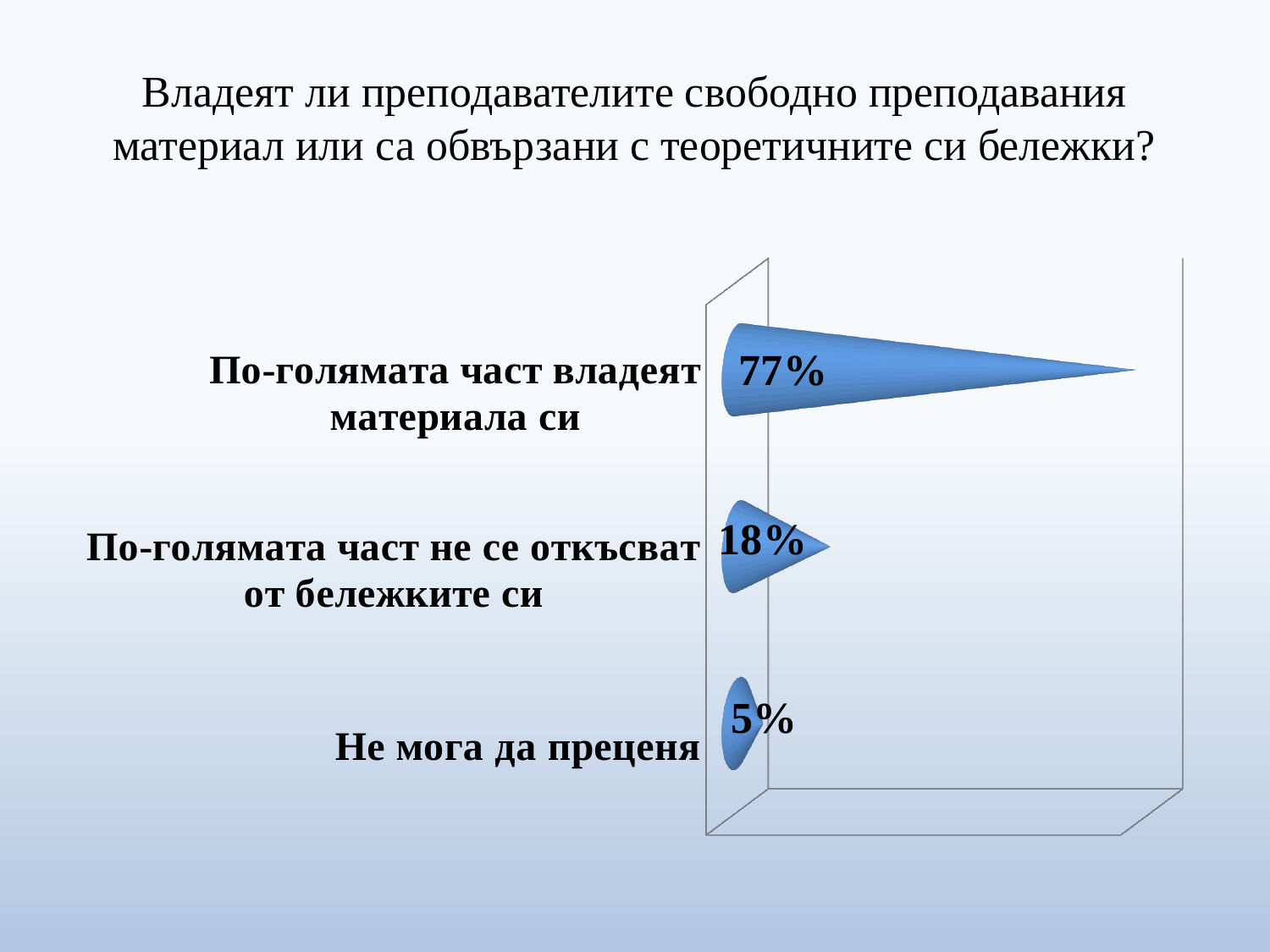
Which is larger: the value for "По-голямата част не се откъсват от бележките си" or the value for "Не мога да преценя"? По-голямата част не се откъсват от бележките си What is the title of the slide? Владеят ли преподавателите свободно преподавания материал или са обвързани с теоретичните си бележки? Which category has the highest value? По-голямата част владеят материала си What colour are the bars in the chart? Blue How many categories are shown in the chart? 3 What is the value for "По-голямата част владеят материала си"? 77% What is the value for "По-голямата част не се откъсват от бележките си"? 18% What is the value for "Не мога да преценя"? 5% What is the difference between the values for "По-голямата част владеят материала си" and "По-голямата част не се откъсват от бележките си"? 59% What is the difference between the values for "По-голямата част не се откъсват от бележките си" and "Не мога да преценя"? 13% Which category has the lowest value? Не мога да преценя What kind of chart is shown on the slide? Bar chart